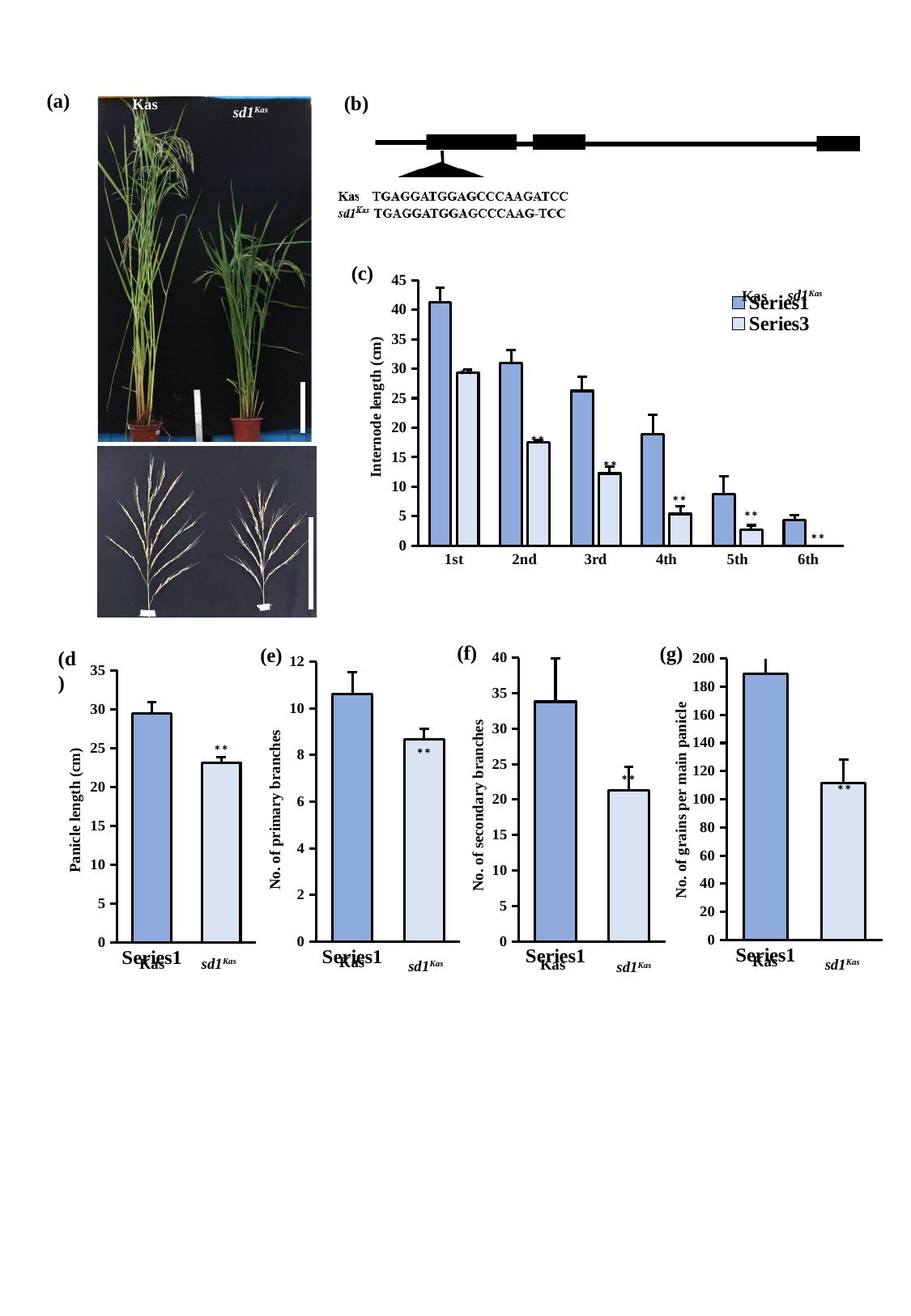
What kind of chart is chart (f), No. of secondary branches? bar chart In chart (c), Internode length, is the Kas value for the 1st internode greater or less than 40? greater In chart (c), Internode length, which internode has the highest Kas value? 1st In chart (g), No. of grains per main panicle, is the value for Kas greater or less than 180? greater In chart (d), Panicle length, is the value for sd1Kas greater or less than 25? less In chart (c), Internode length, which is larger for the 3rd internode, Kas or sd1Kas? Kas In chart (c), Internode length, do the Kas values rise or fall from the 1st to the 6th internode? fall In chart (c), Internode length, how many series does the legend list? 2 In chart (c), Internode length, how many internode categories are shown on the x axis? 6